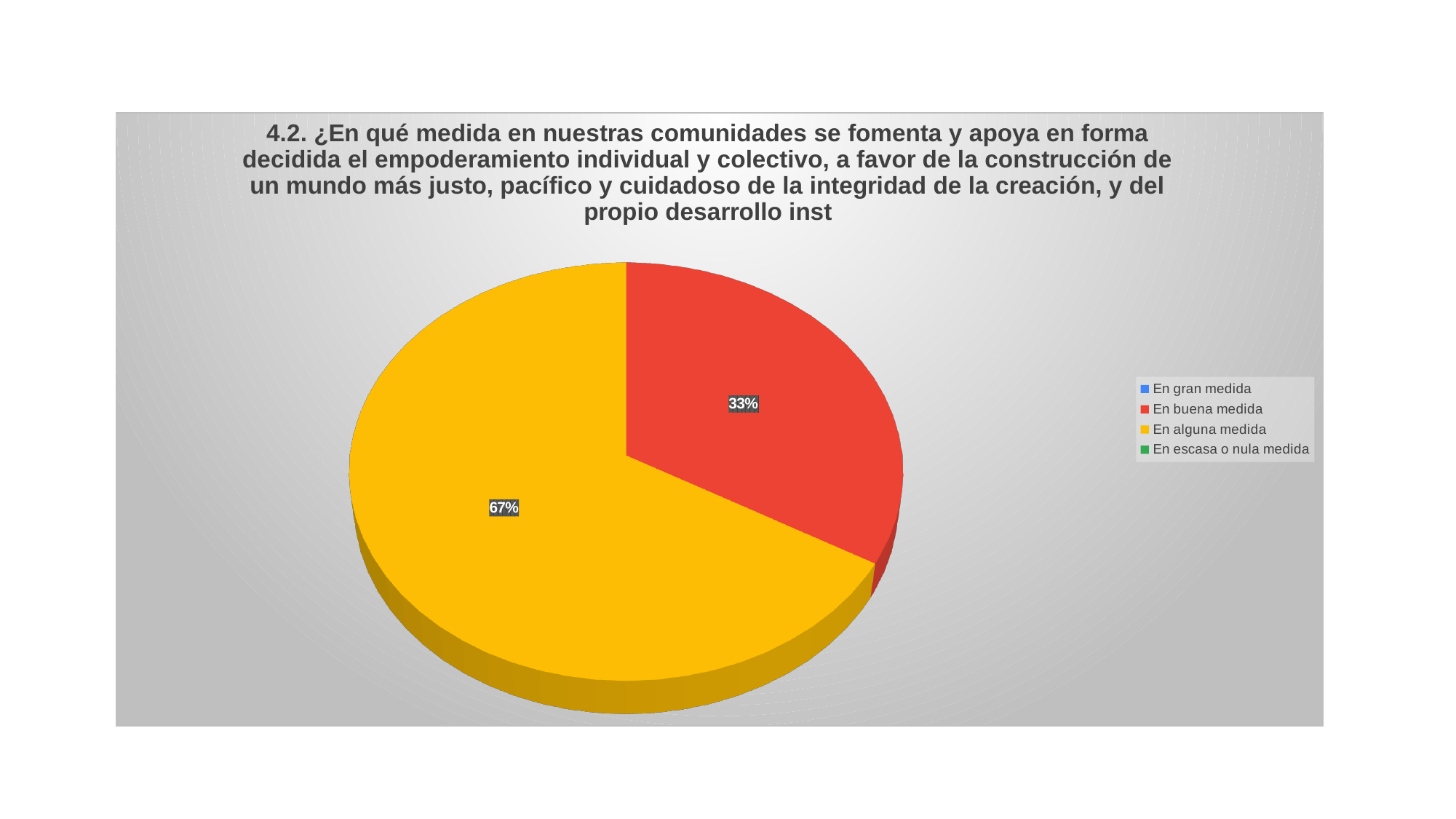
Which category has the largest slice of the pie? En alguna medida What kind of chart is shown on the slide? pie chart What is the difference in percentage points between the "En alguna medida" slice and the "En buena medida" slice? 34 percentage points What colour is the slice for "En alguna medida"? yellow What share of the pie does "En buena medida" represent? 33% Which is larger, the slice for "En buena medida" or the slice for "En alguna medida"? En alguna medida How many entries does the legend list? 4 What share of the pie does "En alguna medida" represent? 67% What colour is the slice for "En buena medida"? red How many slices are visible in the pie? 2